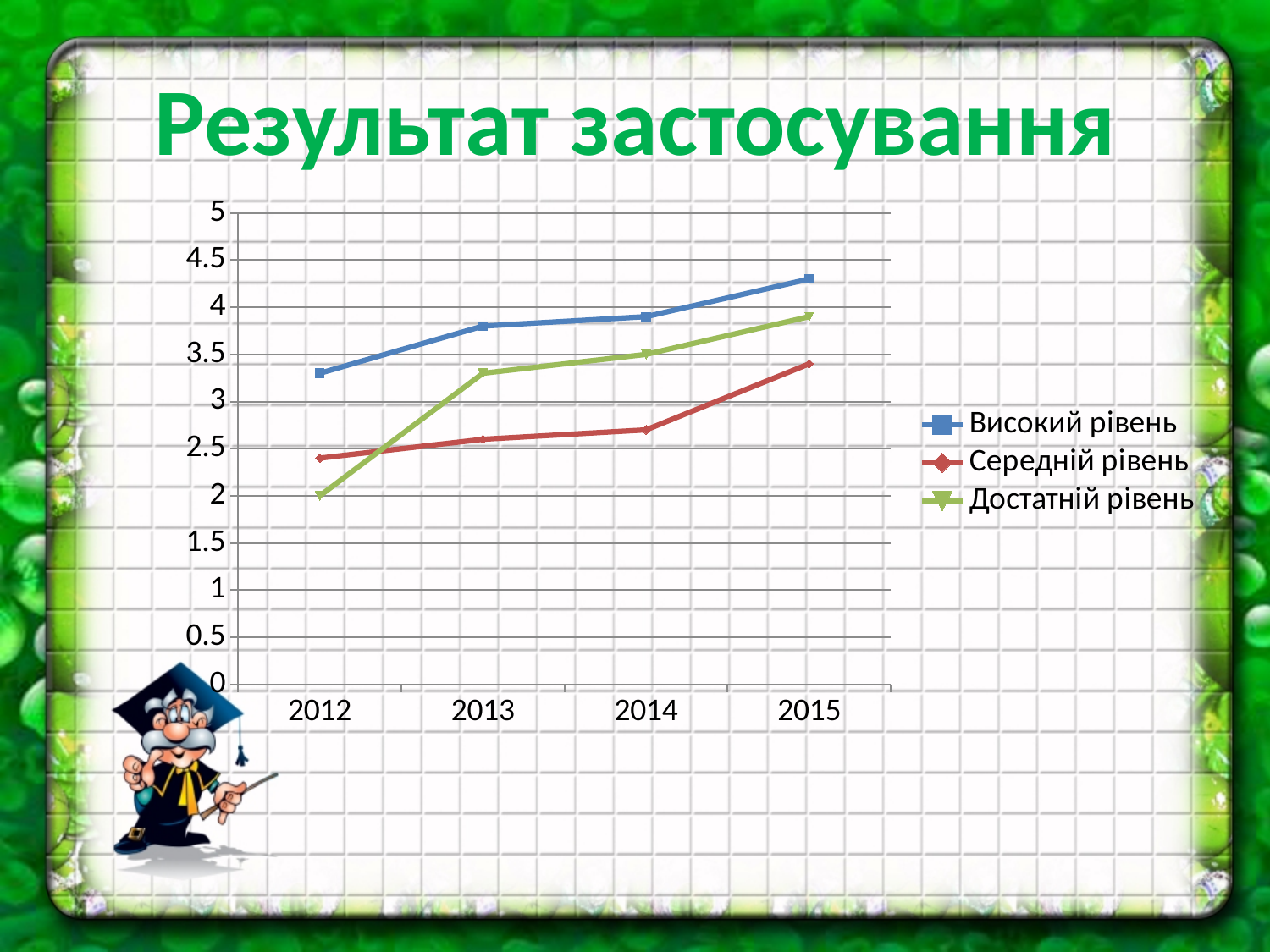
Which series has the highest value in 2015? Високий рівень What kind of chart is shown on the slide? line chart In 2014, which is larger: Високий рівень or Середній рівень? Високий рівень Is the value for Достатній рівень in 2013 greater or less than 3? greater How many series does the legend list? 3 What is the title of the chart? Результат застосування Which series is drawn in red? Середній рівень Is the value for Середній рівень in 2014 greater or less than 3? less Does the Високий рівень line rise or fall from 2012 to 2015? rise Which series has the lowest value in 2012? Достатній рівень How many years are shown on the x axis? 4 Is the value for Високий рівень in 2015 greater or less than 4? greater